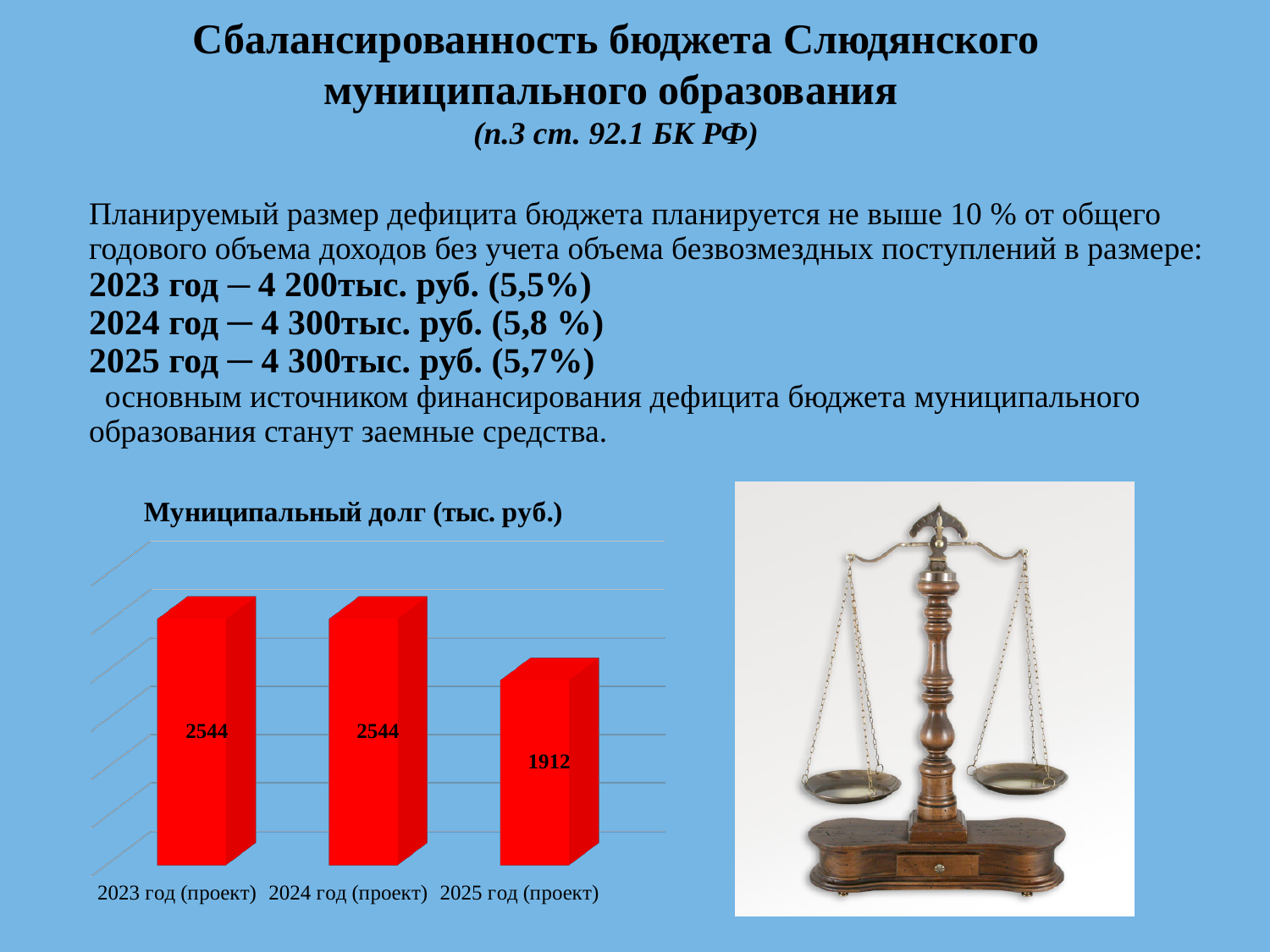
What colour are the bars in the chart? red How many categories are shown in the chart? 3 Which category has the lowest value in the chart? 2025 год (проект) What is the title of the chart? Муниципальный долг (тыс. руб.) What is the difference between the values for 2024 год (проект) and 2025 год (проект)? 632 Which is larger, the value for 2023 год (проект) or 2025 год (проект)? 2023 год (проект) What is the value for 2024 год (проект) in the chart? 2544 Are the values for 2023 год (проект) and 2024 год (проект) equal? yes What kind of chart is shown on the slide? bar chart What is the value for 2023 год (проект) in the chart? 2544 Do the values rise or fall from 2024 год (проект) to 2025 год (проект)? fall What is the value for 2025 год (проект) in the chart? 1912